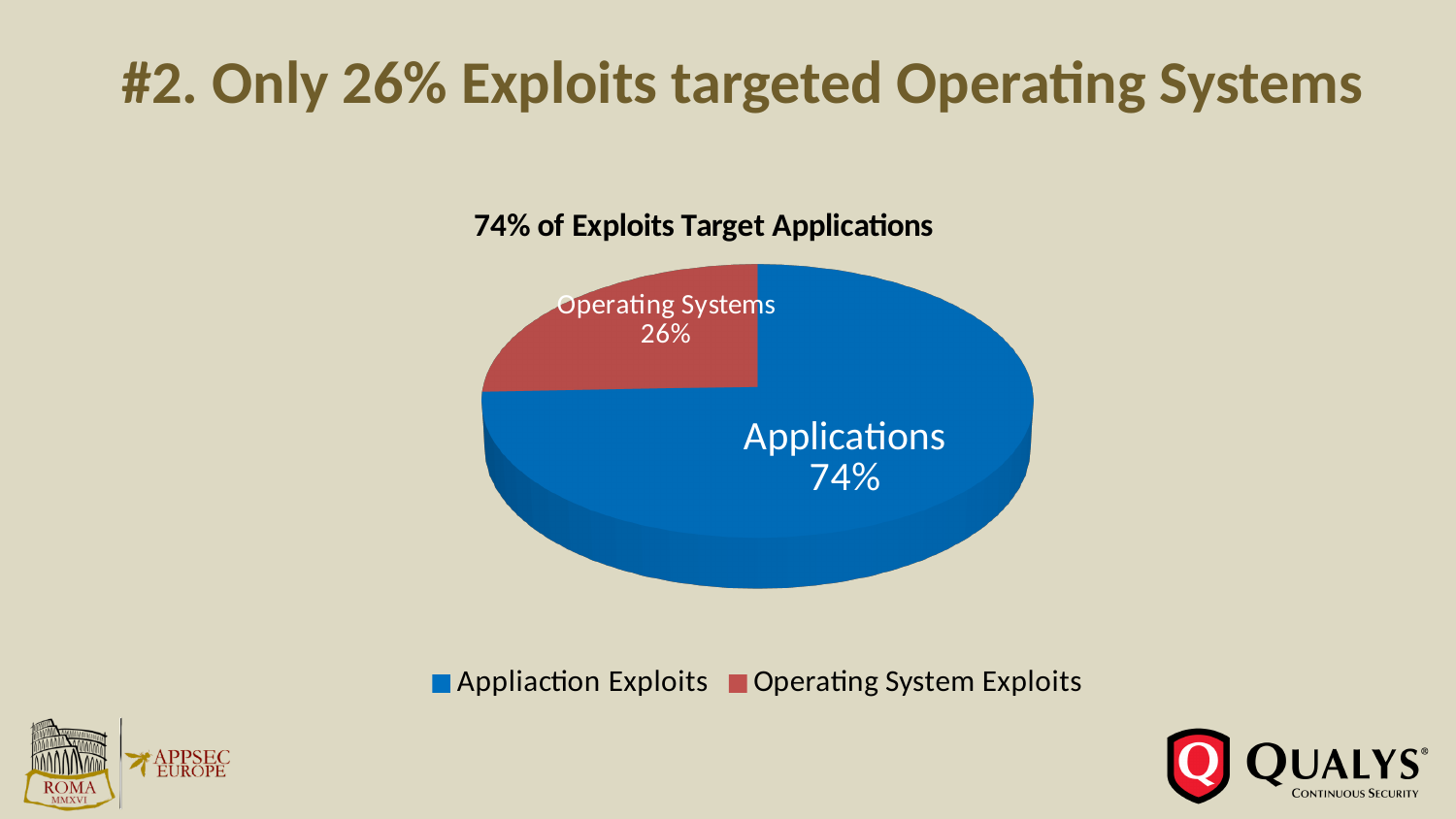
What is the difference in percentage points between the Applications slice and the Operating Systems slice? 48 Which is larger, the Applications slice or the Operating Systems slice? Applications What kind of chart is shown on the slide? Pie chart How many entries does the legend list? 2 Which slice of the pie chart is the largest? Applications Which slice of the pie chart is the smallest? Operating Systems What share of exploits target Operating Systems according to the pie chart? 26% What colour is the Operating System Exploits slice in the pie chart? Red What is the title of the chart? 74% of Exploits Target Applications What is the total of the two slices shown in the pie chart? 100% How many slices does the pie chart have? 2 What share of exploits target Applications according to the pie chart? 74%